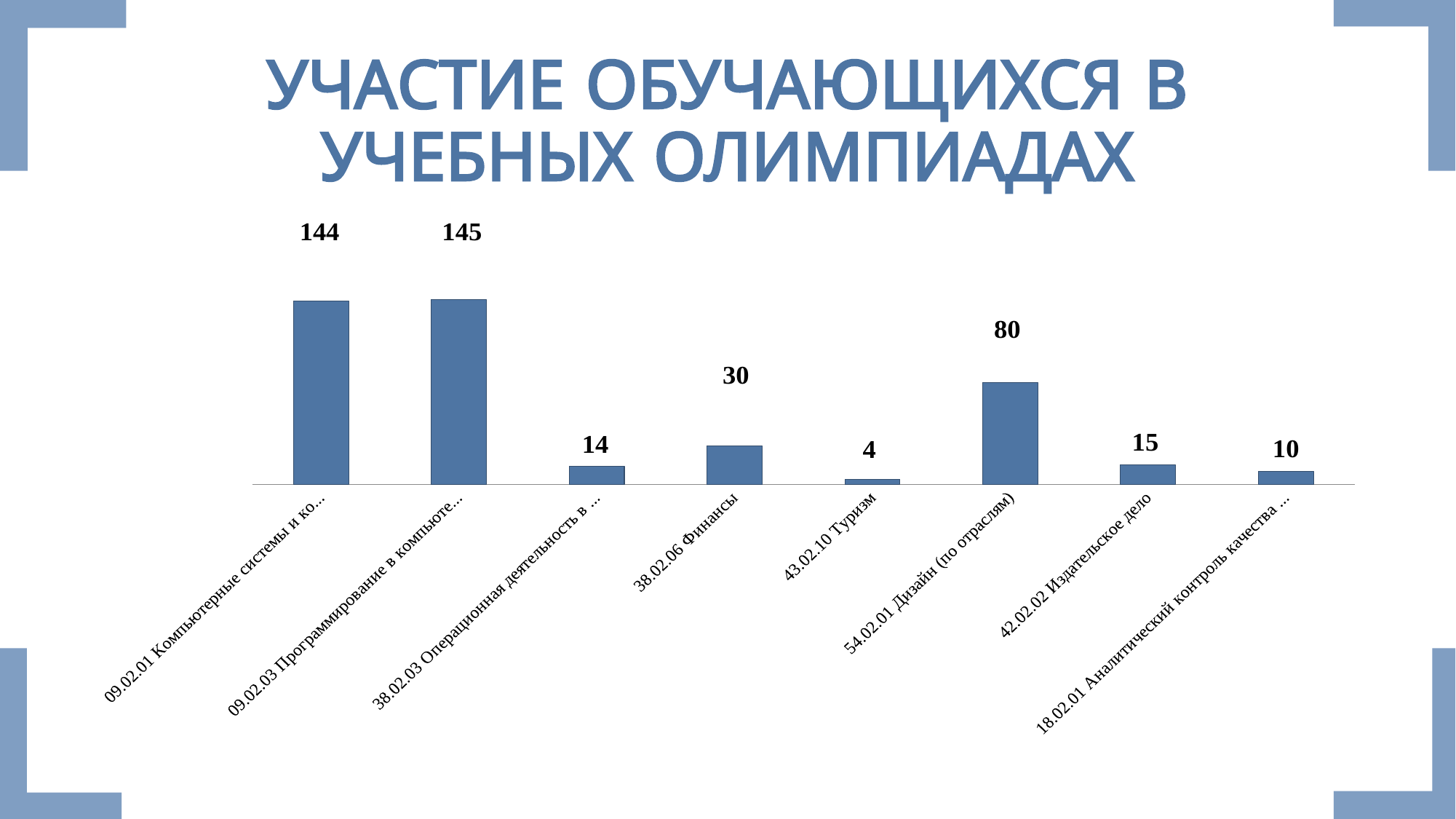
What is the value for the category with code 09.02.01? 144 What kind of chart is shown on the slide? bar chart Which category has the lowest value? 43.02.10 Туризм Which category has the highest value? 09.02.03 Программирование в компьюте... What is the value for 38.02.06 Финансы? 30 Which is larger: the value for 42.02.02 Издательское дело or the value for the category with code 18.02.01? 42.02.02 Издательское дело What is the difference between the values for 54.02.01 Дизайн (по отраслям) and 38.02.06 Финансы? 50 What is the value for 42.02.02 Издательское дело? 15 What is the value for 54.02.01 Дизайн (по отраслям)? 80 What is the title of the slide? УЧАСТИЕ ОБУЧАЮЩИХСЯ В УЧЕБНЫХ ОЛИМПИАДАХ How many categories are shown in the chart? 8 What is the value for 43.02.10 Туризм? 4